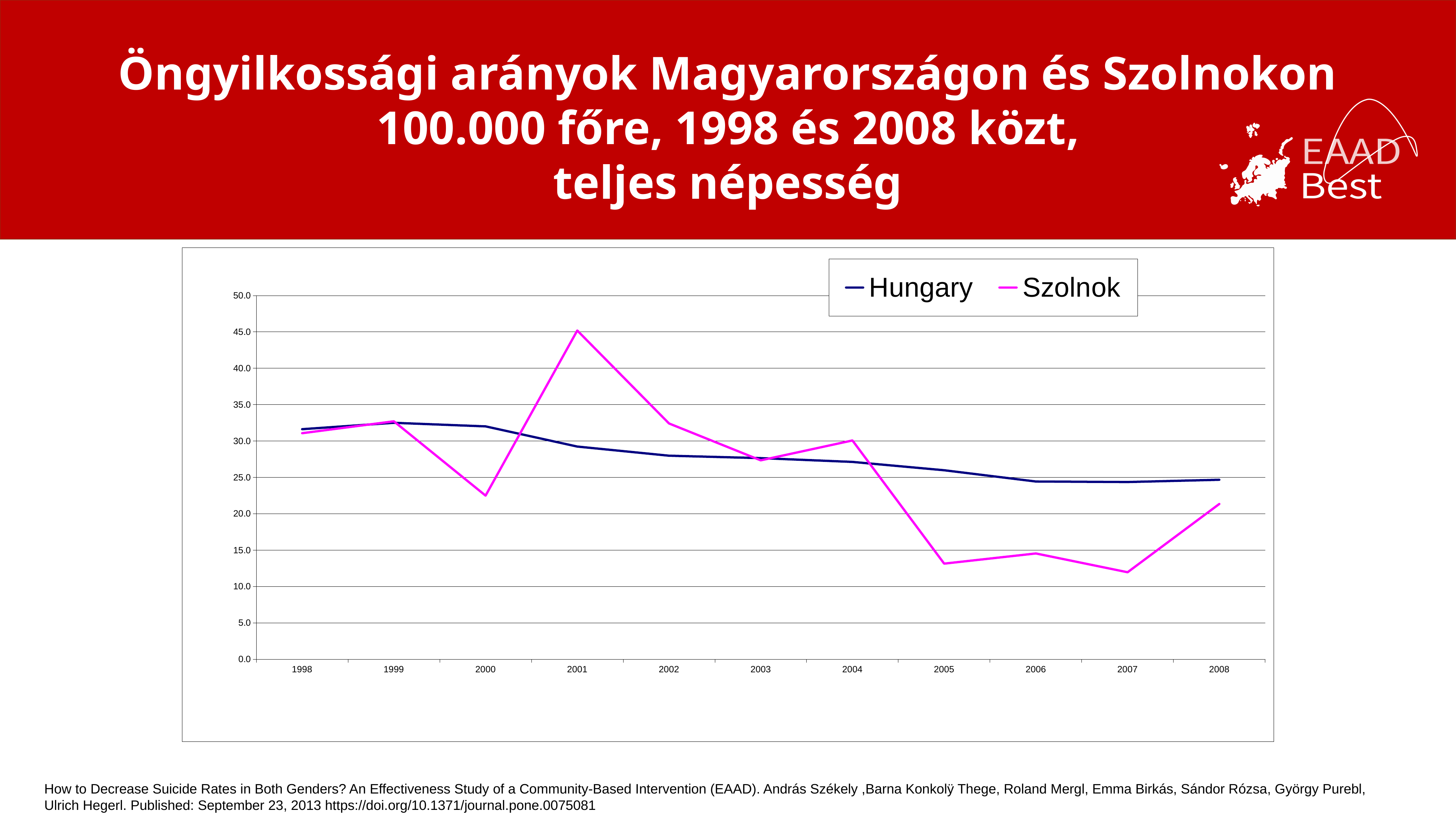
What kind of chart is shown on the slide? line chart How many years are plotted along the x axis? 11 Is the value for Szolnok in 2005 greater or less than 15.0? less Does the Hungary series generally rise or fall from 1998 to 2008? fall How many series does the legend list? 2 In which year does the Szolnok series reach its lowest value? 2007 In 2005, which series has the larger value, Hungary or Szolnok? Hungary In which year does the Szolnok series reach its highest value? 2001 Is the value for Szolnok in 2001 greater or less than 40.0? greater What colour is the Szolnok line? magenta (pink) Is the value for Hungary in 2008 greater or less than 30.0? less In 2001, which series has the larger value, Hungary or Szolnok? Szolnok